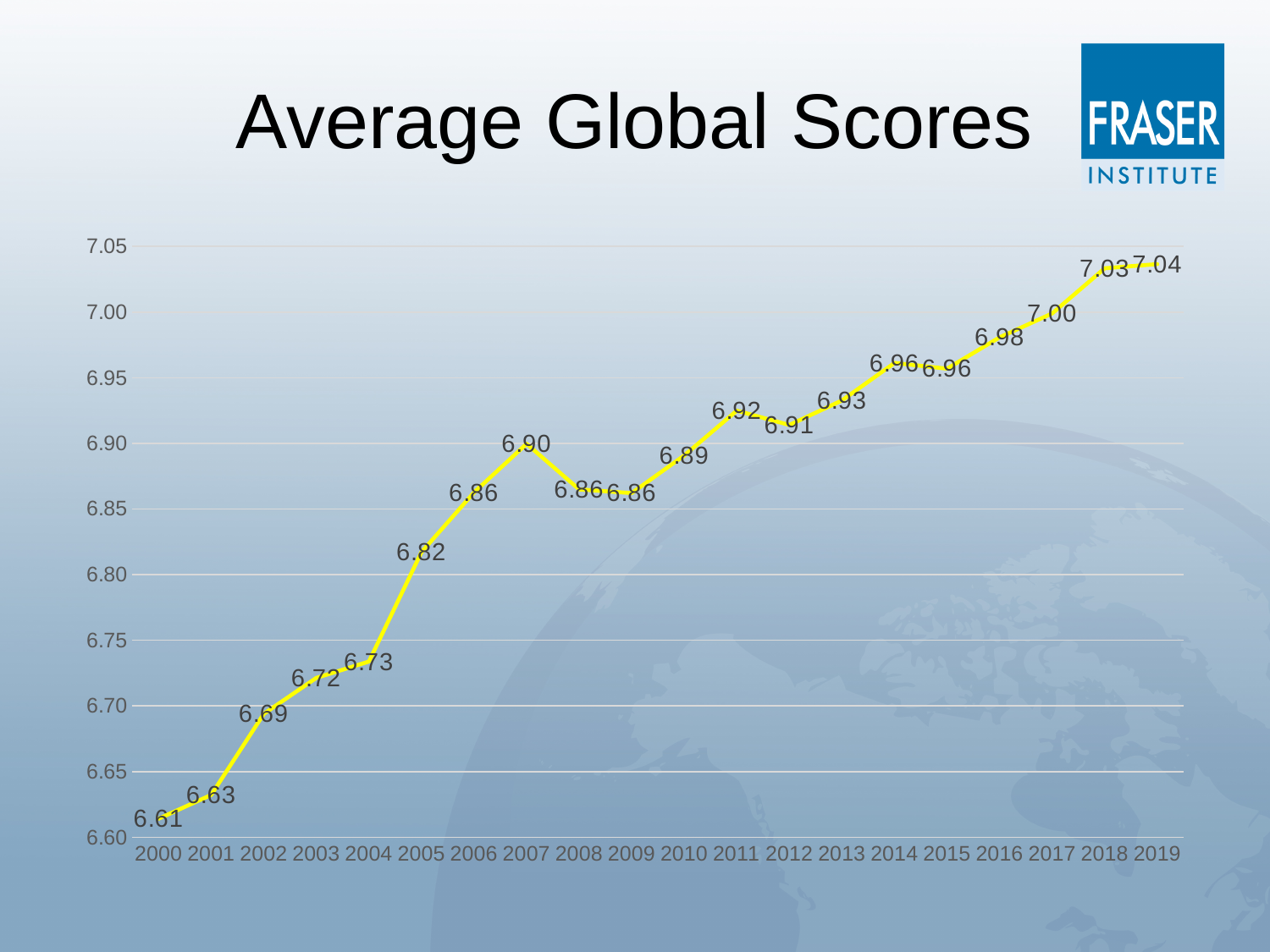
Which year has a higher average global score, 2007 or 2008? 2007 What is the difference between the average global score in 2019 and in 2000? 0.43 Is the average global score for 2005 greater or less than 6.80? greater What is the average global score for 2013? 6.93 How many years are plotted on the chart? 20 What kind of chart is shown on the slide? Line chart Do the average global scores generally rise or fall from 2000 to 2019? Rise What is the title of the chart? Average Global Scores Which year has the lowest average global score? 2000 What is the average global score for 2007? 6.90 Which year has the highest average global score? 2019 What is the average global score for 2000? 6.61